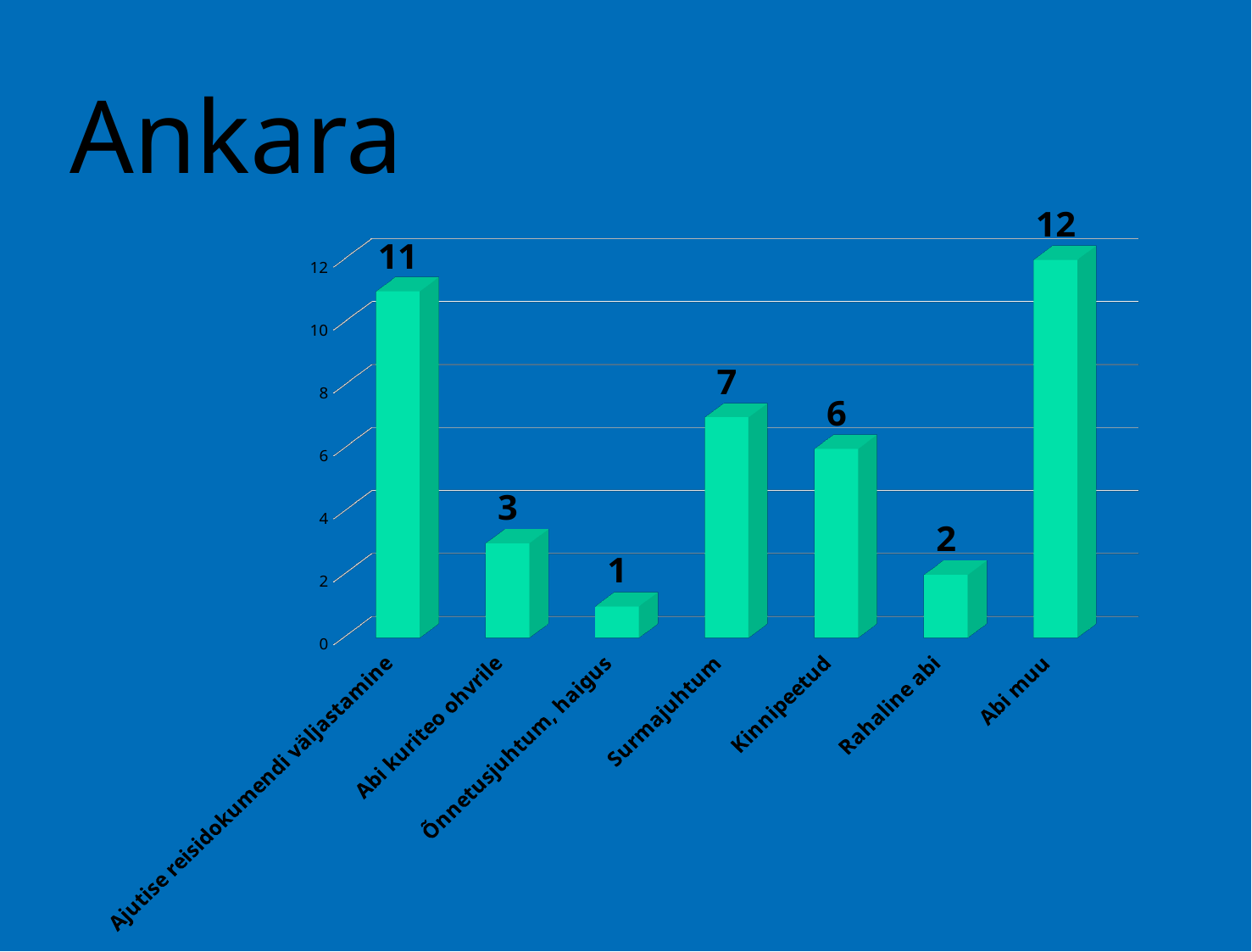
What is the title of the slide? Ankara What is the value for Surmajuhtum? 7 Is the value for Surmajuhtum greater or less than 8? less How many categories are shown on the chart? 7 Which category has the lowest value? Õnnetusjuhtum, haigus Which is larger, the value for Abi kuriteo ohvrile or the value for Kinnipeetud? Kinnipeetud What is the difference between the values for Abi muu and Kinnipeetud? 6 Which category has the highest value? Abi muu What is the difference between the values for Ajutise reisidokumendi väljastamine and Abi kuriteo ohvrile? 8 What kind of chart is shown on the slide? bar chart What is the value for Ajutise reisidokumendi väljastamine? 11 What is the value for Rahaline abi? 2